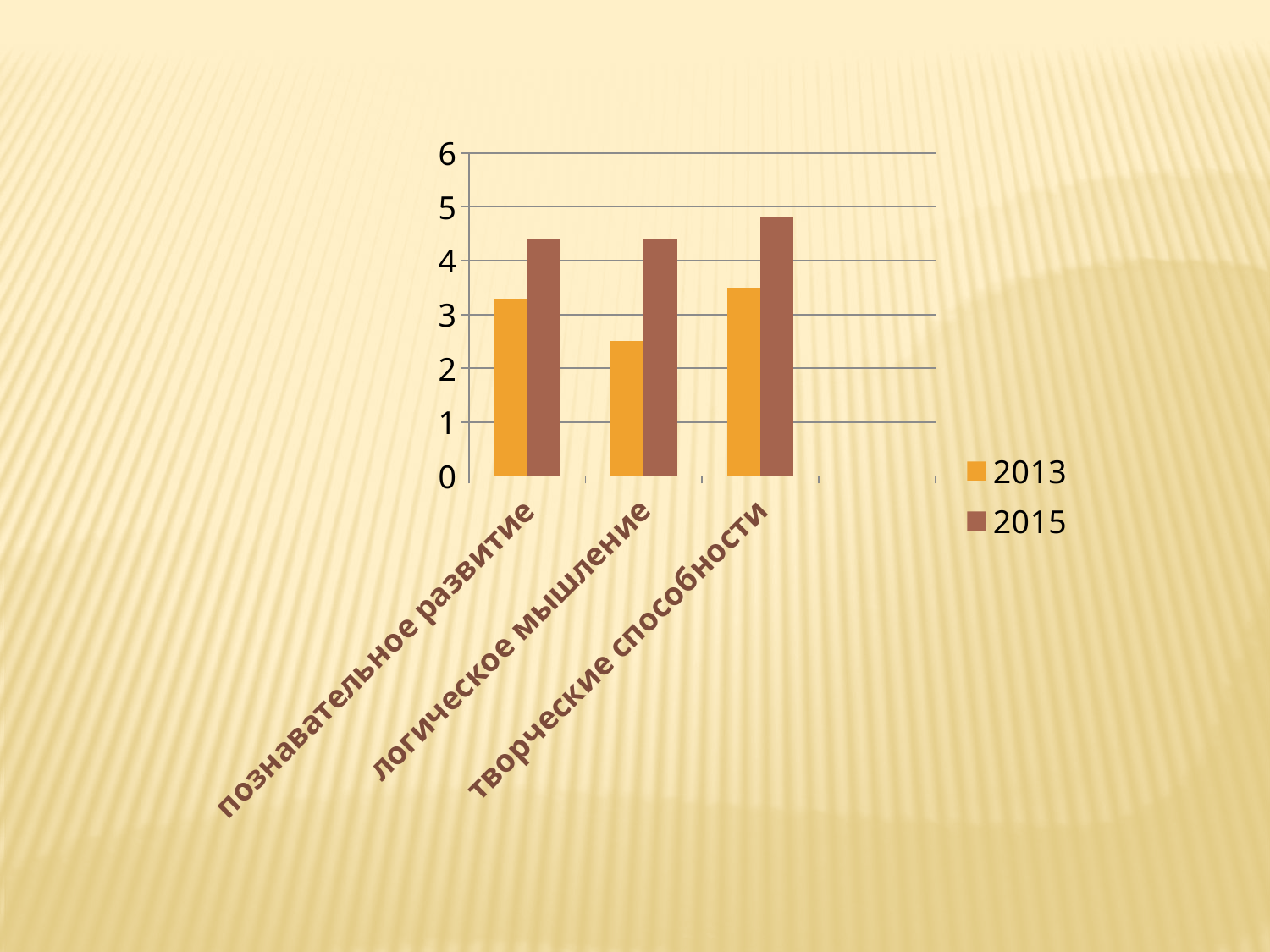
For познавательное развитие, which series has the larger value, 2013 or 2015? 2015 Is the 2015 value for творческие способности greater or less than 4? greater What kind of chart is shown on the slide? bar chart Which category has the highest value for 2015? творческие способности How many series does the legend list? 2 Which series is shown in orange? 2013 For логическое мышление, which series has the larger value, 2013 or 2015? 2015 Is the 2015 value for логическое мышление greater or less than 4? greater How many categories are shown on the x axis? 3 Is the 2013 value for логическое мышление greater or less than 3? less Which category has the lowest value for 2013? логическое мышление